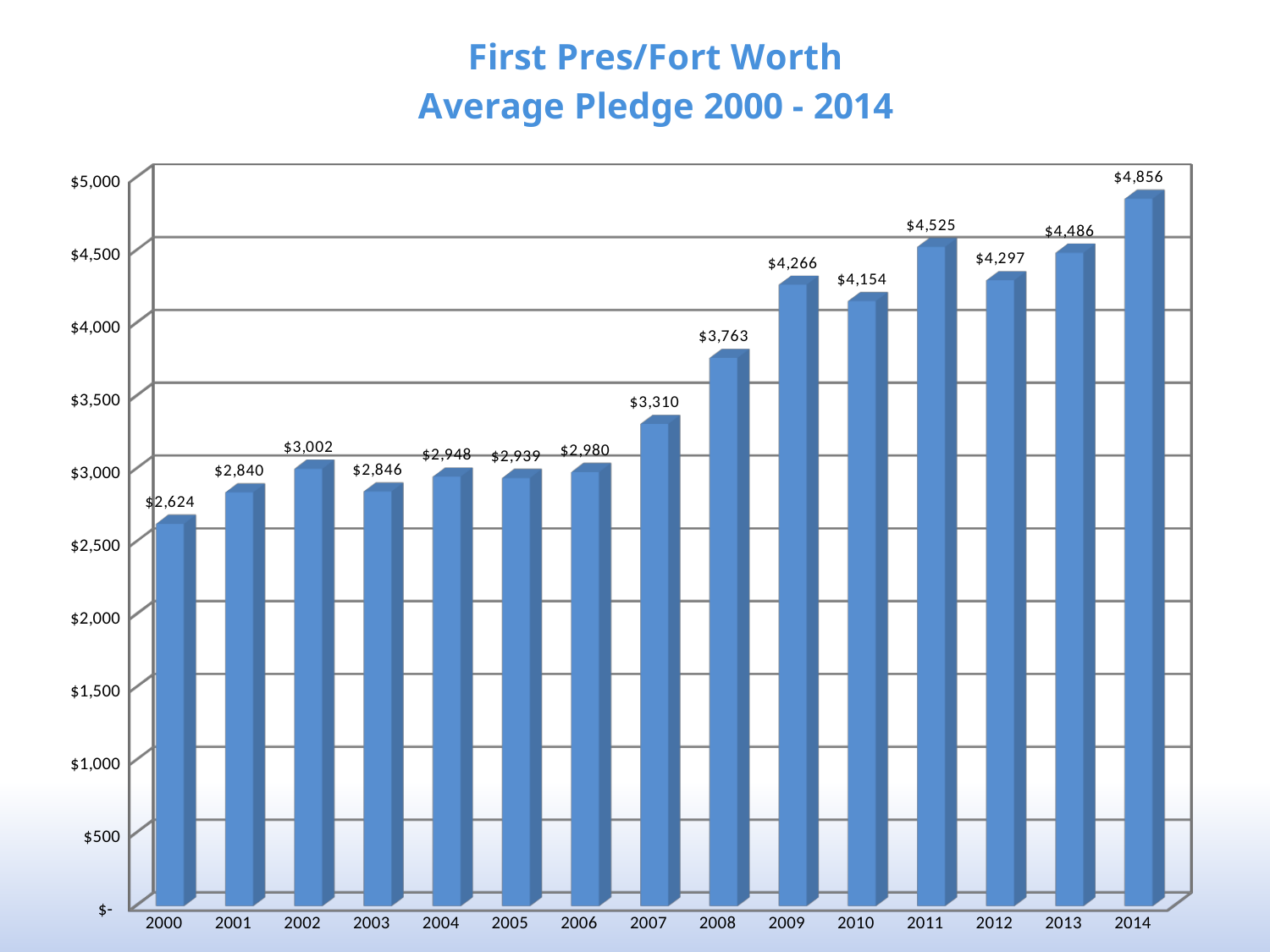
Which year has a larger average pledge, 2009 or 2010? 2009 Which year has a larger average pledge, 2002 or 2003? 2002 What is the title of the chart? First Pres/Fort Worth Average Pledge 2000 - 2014 What is the average pledge for 2012? $4,297 What is the average pledge for 2008? $3,763 What is the average pledge for 2000? $2,624 Which year has the highest average pledge? 2014 How many years are shown on the x axis? 15 What is the difference between the average pledge in 2011 and in 2010? $371 What is the difference between the average pledge in 2014 and in 2000? $2,232 What kind of chart is shown on the slide? Bar chart Which year has the lowest average pledge? 2000